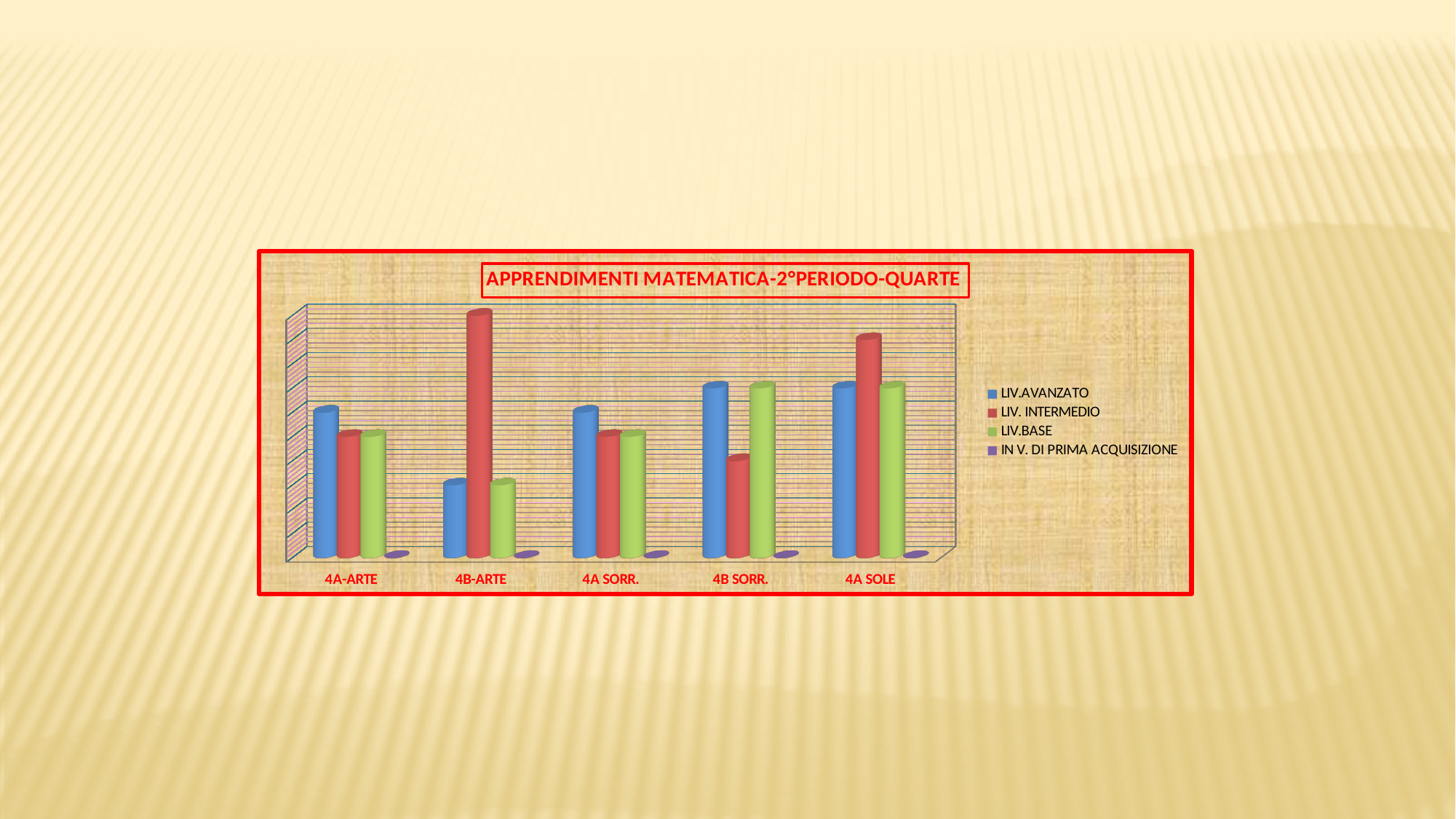
Which series is shown in red in the legend? LIV. INTERMEDIO Which category has the lowest LIV.BASE bar? 4B-ARTE Which category has the lowest LIV. INTERMEDIO bar? 4B SORR. What kind of chart is shown on the slide? Bar chart How many series does the legend list? 4 Which category has the lowest LIV.AVANZATO bar? 4B-ARTE In 4A SOLE, which is larger: LIV. INTERMEDIO or LIV.BASE? LIV. INTERMEDIO How many categories are shown on the x axis? 5 In 4B SORR., which is larger: LIV.AVANZATO or LIV. INTERMEDIO? LIV.AVANZATO What is the title of the chart? APPRENDIMENTI MATEMATICA-2°PERIODO-QUARTE In 4B-ARTE, which is larger: LIV.AVANZATO or LIV. INTERMEDIO? LIV. INTERMEDIO Which category has the highest LIV. INTERMEDIO bar? 4B-ARTE